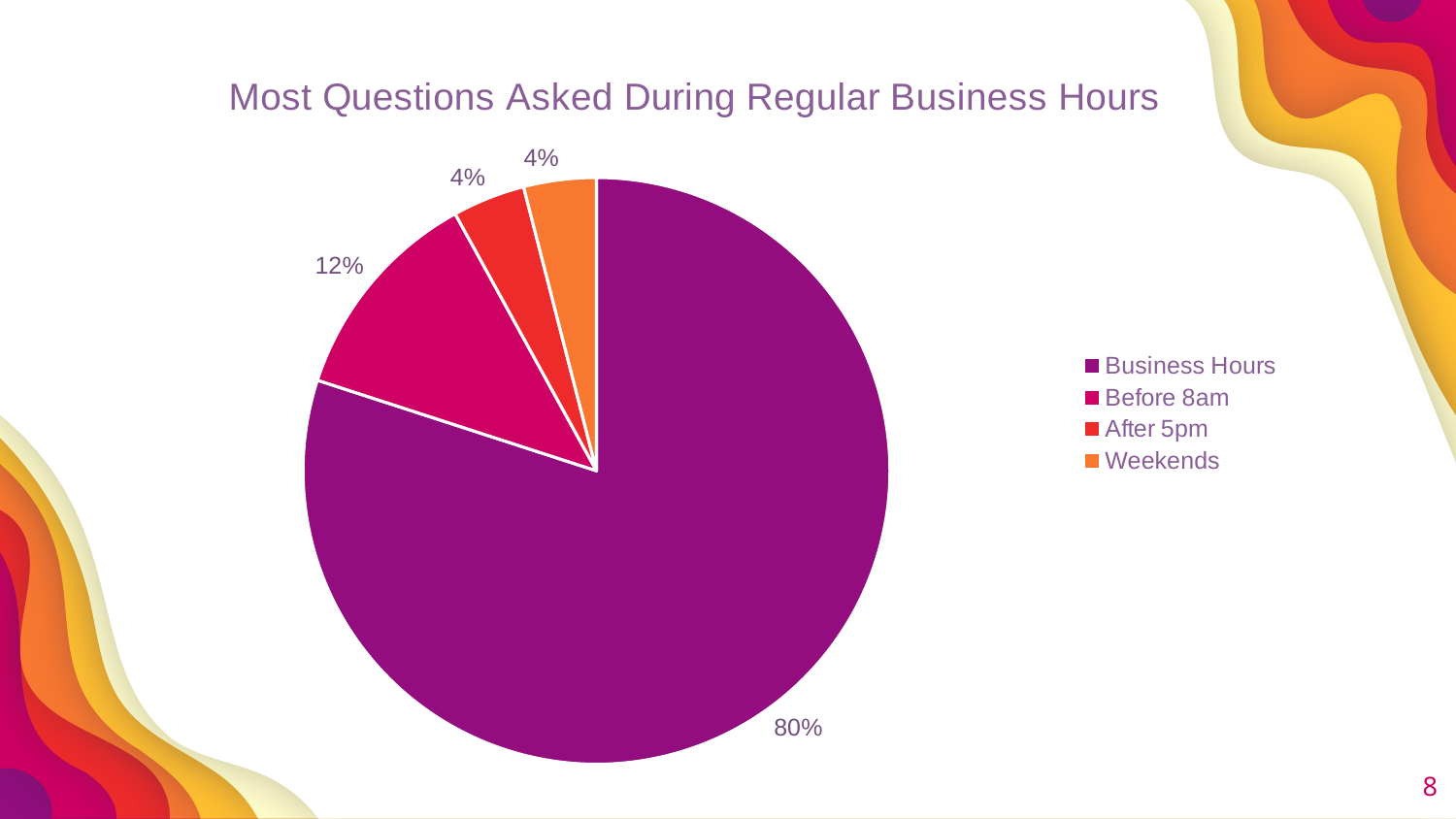
What is the title of the chart? Most Questions Asked During Regular Business Hours What share of the pie does Before 8am represent? 12% What share of the pie does Business Hours represent? 80% Which category has the largest slice of the pie? Business Hours What is the difference between the Business Hours share and the Before 8am share? 68% Which is larger, the Before 8am share or the Weekends share? Before 8am What share of the pie does After 5pm represent? 4% How many categories does the legend list? 4 What is the combined share of After 5pm and Weekends? 8% What colour is the Weekends slice? Orange What share of the pie does Weekends represent? 4% What kind of chart is shown on the slide? Pie chart